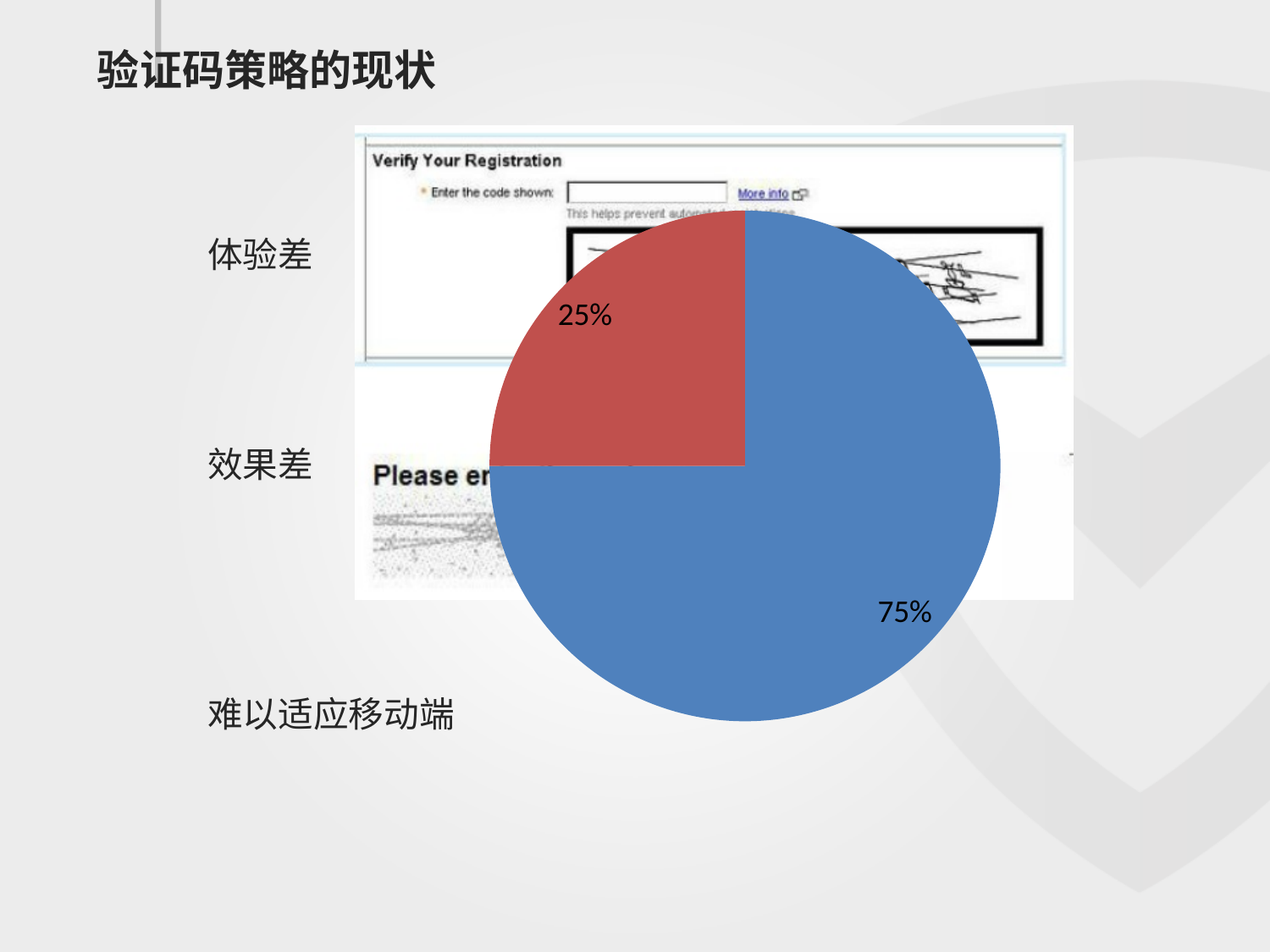
What percentage is shown on the red slice of the pie chart? 25% What kind of chart is shown on the slide? pie chart What percentage is shown on the blue slice of the pie chart? 75% What do the two percentages on the pie chart add up to? 100% How many slices does the pie chart have? 2 What share of the pie does the red slice represent? 25% Which slice of the pie chart is the largest? the blue slice (75%) What two colours are used for the slices of the pie chart? blue and red What is the difference in percentage points between the blue slice and the red slice of the pie chart? 50 percentage points What share of the pie does the blue slice represent? 75% Which is larger in the pie chart, the blue slice or the red slice? the blue slice Which slice of the pie chart is the smallest? the red slice (25%)